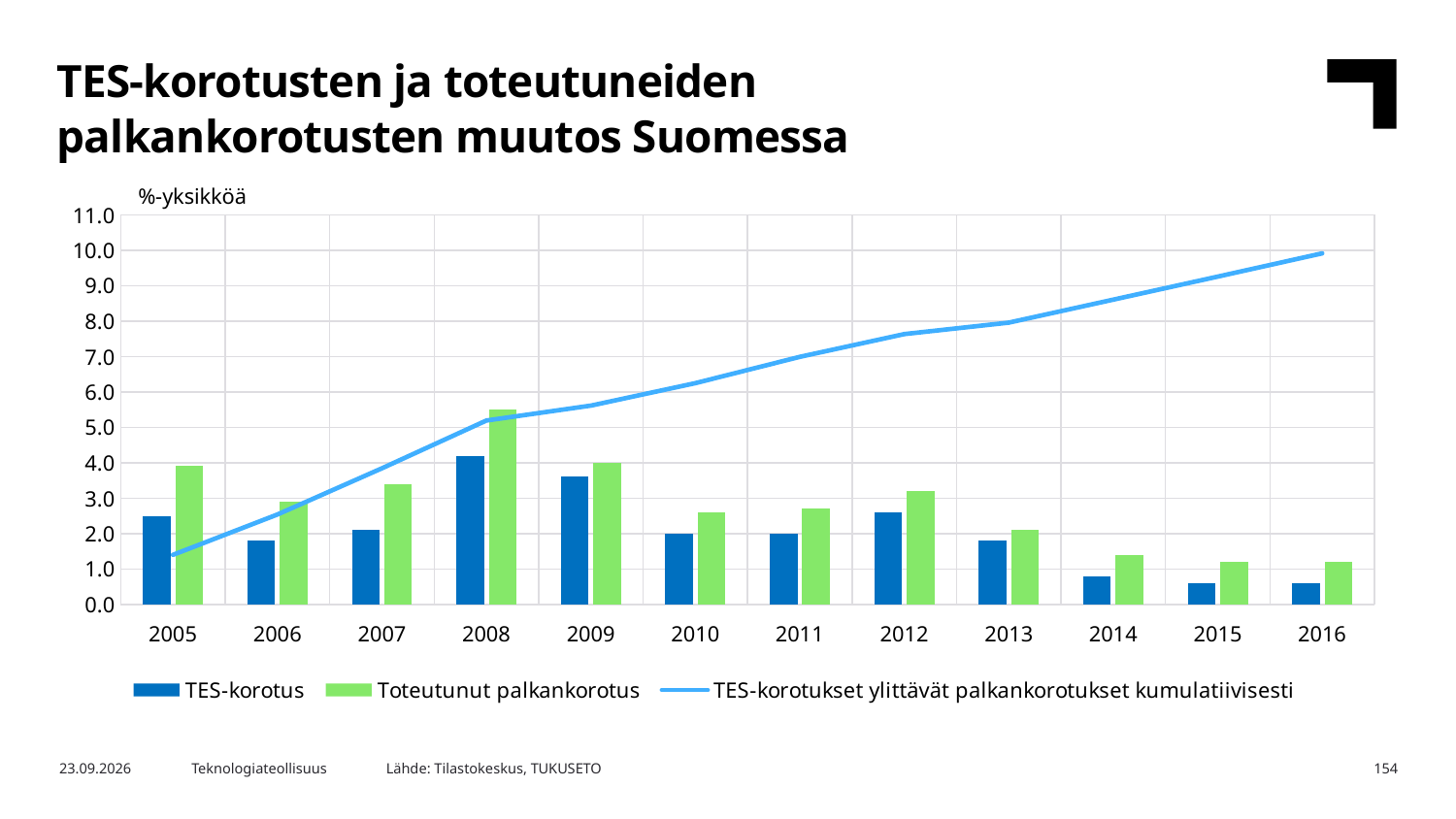
In 2005, which is larger: TES-korotus or Toteutunut palkankorotus? Toteutunut palkankorotus What kind of chart is shown on the slide? bar chart with a line Is the value of the TES-korotukset ylittävät palkankorotukset kumulatiivisesti line in 2016 greater or less than 9.0? greater In which year is the TES-korotus bar highest? 2008 How many series does the legend list? 3 Is the Toteutunut palkankorotus value for 2008 greater or less than 5.0? greater Is the value of the TES-korotukset ylittävät palkankorotukset kumulatiivisesti line in 2005 greater or less than 2.0? less How many years are shown on the x axis? 12 In which year is the Toteutunut palkankorotus bar highest? 2008 Does the TES-korotukset ylittävät palkankorotukset kumulatiivisesti line rise or fall from 2005 to 2016? rise What unit is shown above the y axis? %-yksikköä